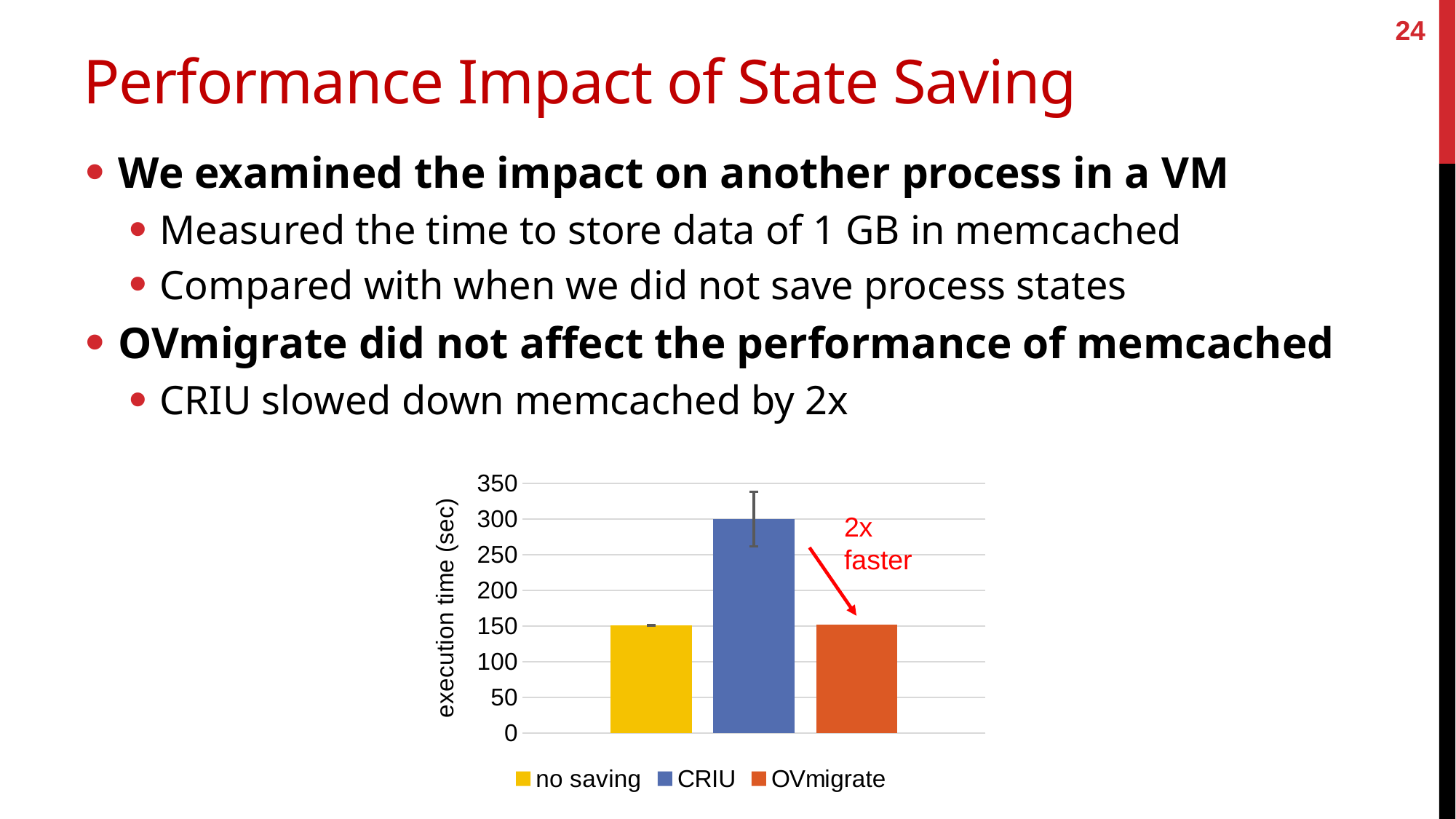
Which has a larger execution time, CRIU or OVmigrate? CRIU What is the highest value shown on the vertical axis of the chart? 350 Which series has the highest execution time in the chart? CRIU Is the execution time for no saving greater or less than 100? greater What is the label of the vertical axis of the chart? execution time (sec) What kind of chart is shown on the slide? bar chart What does the red annotation next to the OVmigrate bar say? 2x faster Is the execution time for CRIU greater or less than 250? greater How many series does the chart legend list? 3 How many bars are plotted in the chart? 3 Which has a larger execution time, no saving or CRIU? CRIU Is the execution time for OVmigrate greater or less than 200? less